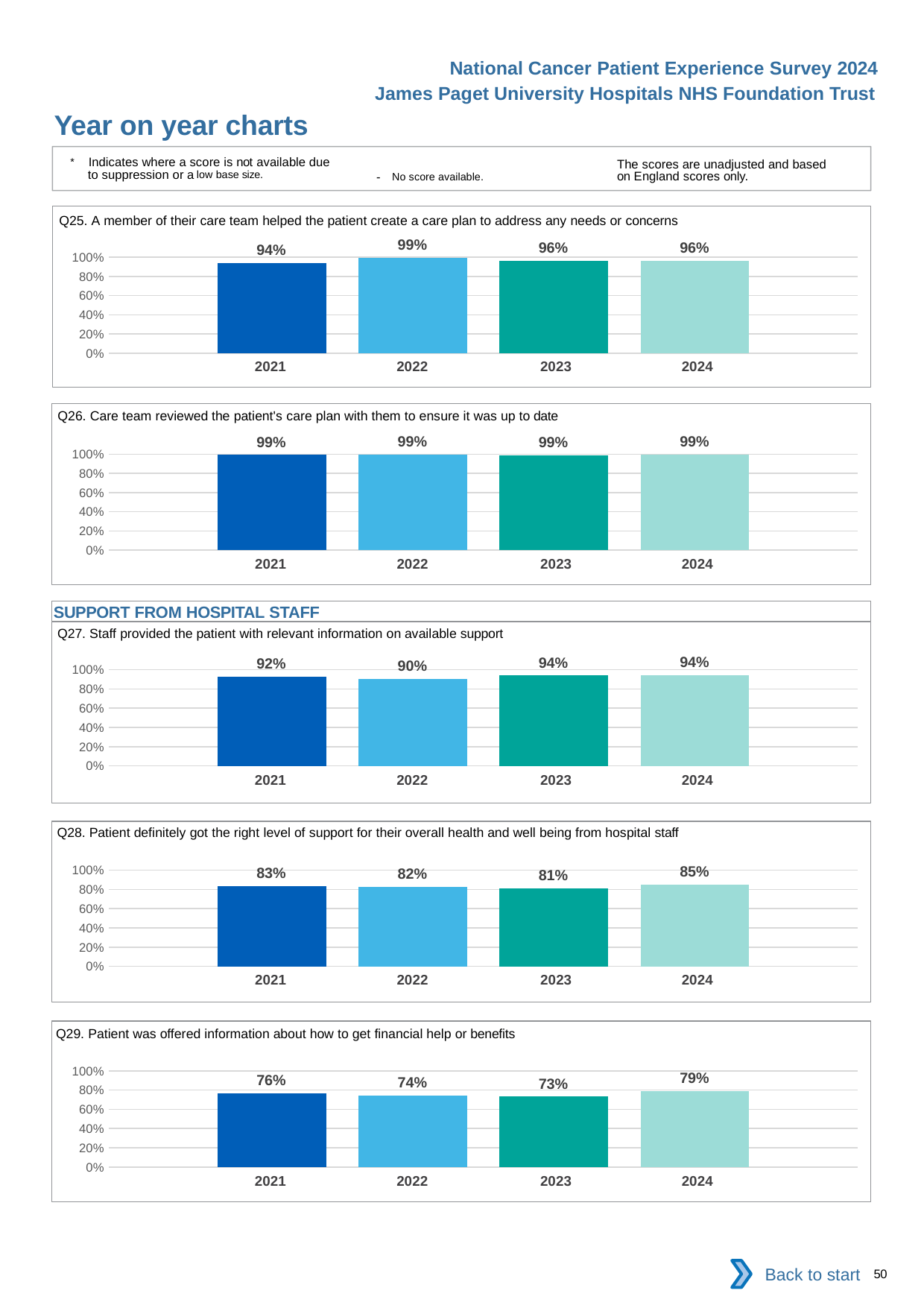
In the Q29 chart, is the value for 2022 greater or less than 80%? less In the Q26 chart, what is the value for 2024? 99% In the Q28 chart, which year has the highest value? 2024 In the Q28 chart, what is the value for 2023? 81% What kind of chart is the Q28 chart? Bar chart In the Q25 chart, what is the value for 2022? 99% In the Q29 chart, how many years are plotted? 4 In the Q29 chart, is the value for 2021 larger or the value for 2023? 2021 In the Q27 chart, what is the difference between the 2023 value and the 2022 value? 4% In the Q25 chart, which year has the lowest value? 2021 In the Q27 chart, which year has the lowest value? 2022 In the Q29 chart, what is the difference between the 2024 value and the 2023 value? 6%